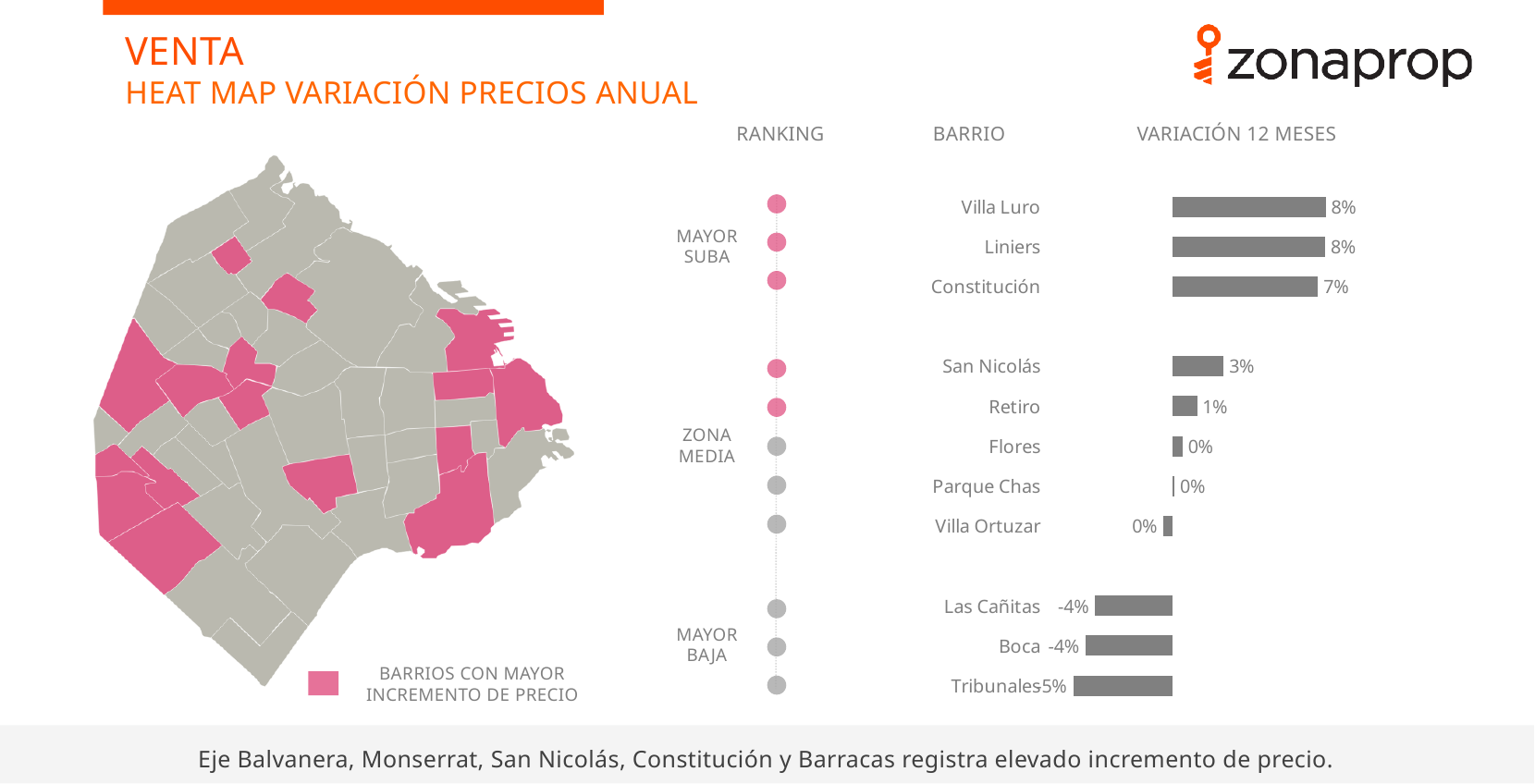
What is the 12-month variation shown for Boca? -4% What is the 12-month variation shown for Las Cañitas? -4% What kind of chart shows the 12-month variation by barrio? Bar chart What is the 12-month variation shown for San Nicolás? 3% What are the three ranking groups labelled on the chart? Mayor suba, Zona media, Mayor baja What is the 12-month variation shown for Constitución? 7% What is the 12-month variation shown for Retiro? 1% Do the variation values rise or fall going down the ranking from Villa Luro to Tribunales? Fall Which has a larger 12-month variation, Constitución or San Nicolás? Constitución What is the 12-month variation shown for Villa Luro? 8% What is the difference in percentage points between the variation for Villa Luro and the variation for San Nicolás? 5 percentage points How many barrios are listed in the ranking chart? 11